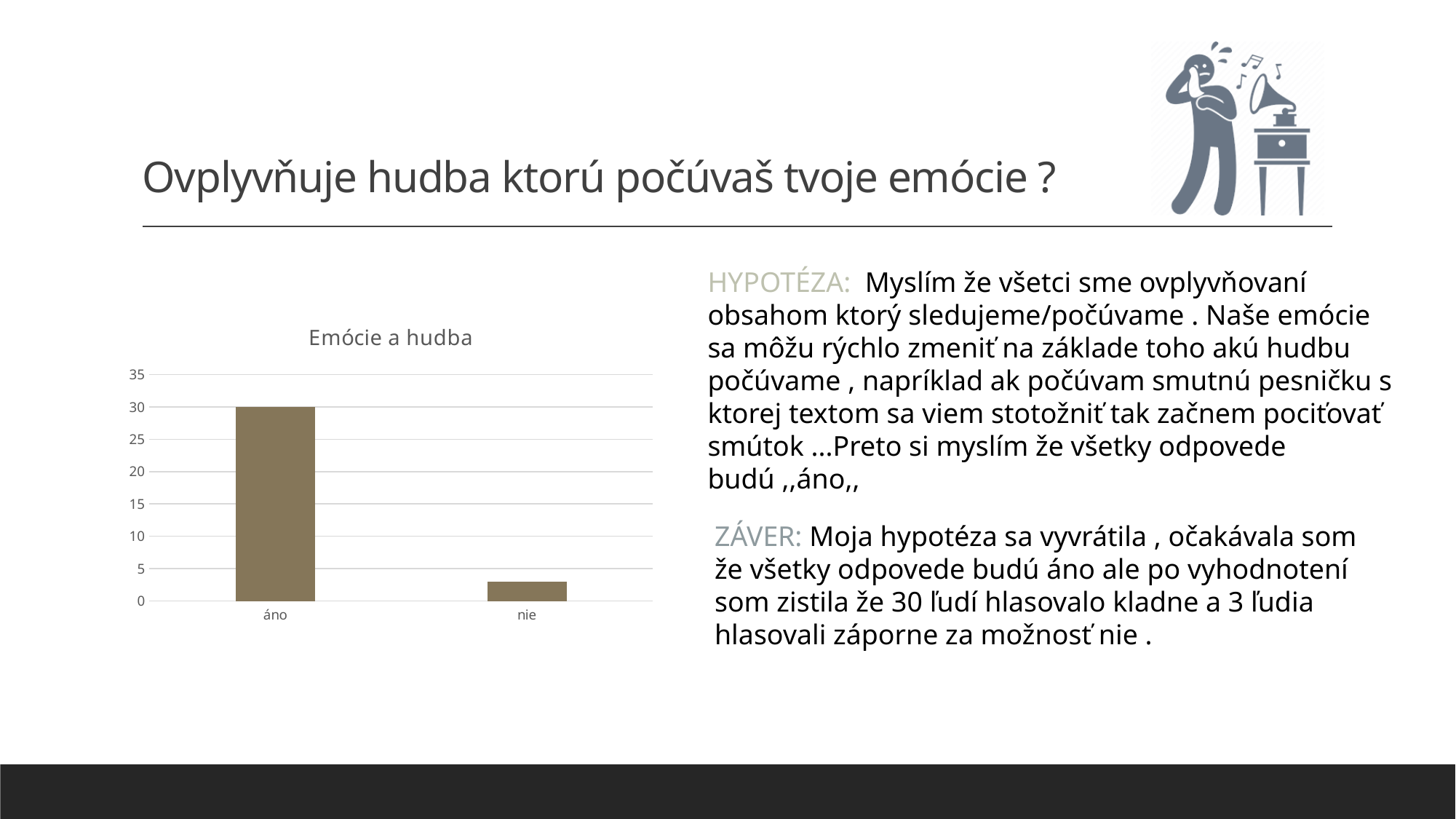
What is the title of the chart? Emócie a hudba Do the values rise or fall from "áno" to "nie" along the x axis? fall Is the value for "áno" greater or less than 25? greater What is the highest value shown on the y axis of the chart? 35 Is the value for "nie" greater or less than 5? less How many categories are shown on the x axis of the chart? 2 What type of chart is shown on the slide? bar chart Which category has the lowest value in the chart? nie Which is larger, the value for "áno" or the value for "nie"? áno What is the value for "áno" in the chart? 30 Which category has the highest value in the chart? áno